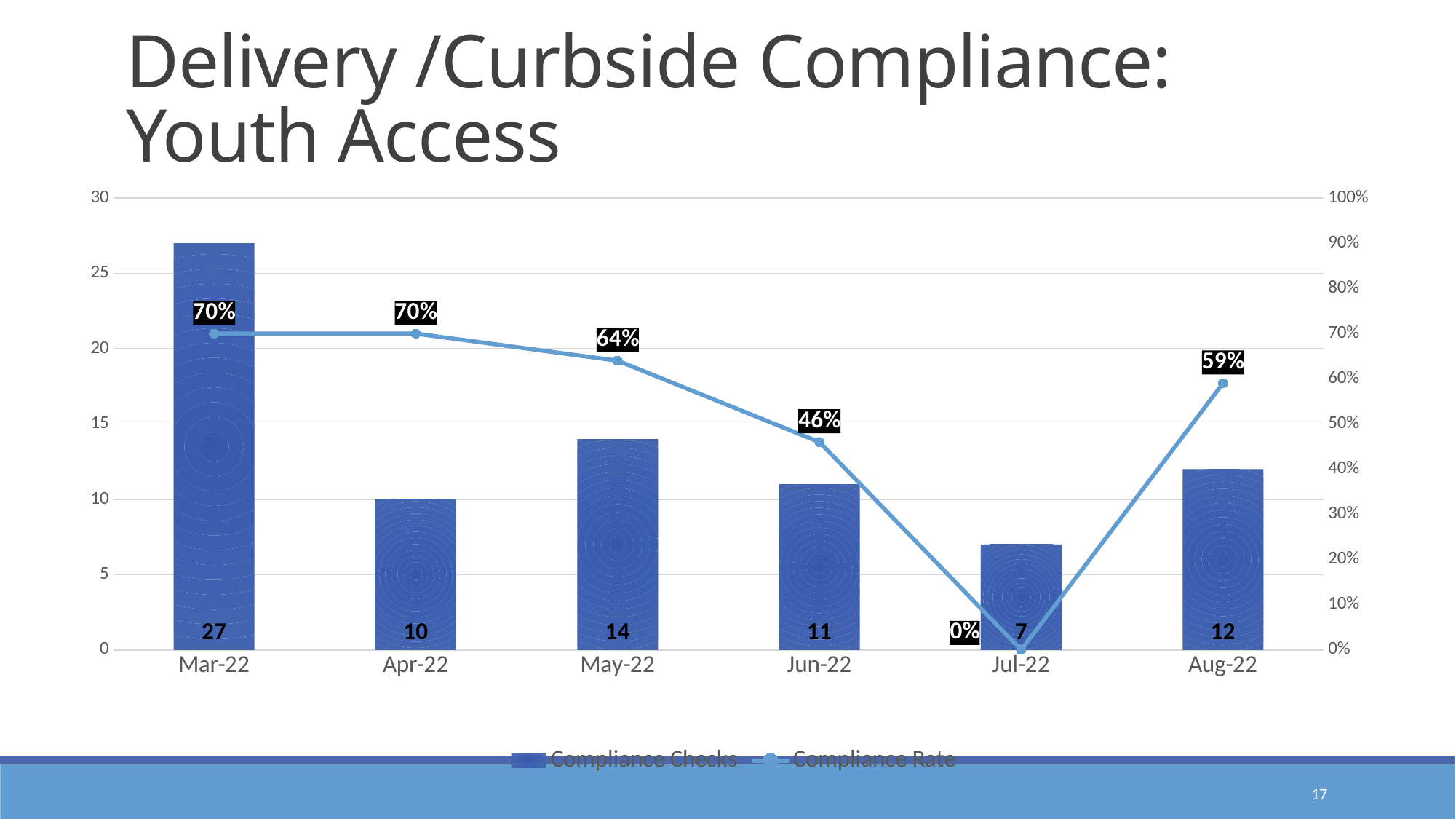
How many series does the legend list? 2 Which month had more compliance checks, May-22 or Jun-22? May-22 How many months are shown on the x axis? 6 What is the title of the slide containing the chart? Delivery /Curbside Compliance: Youth Access Does the compliance rate rise or fall from Apr-22 to Jul-22? Fall What was the compliance rate in Aug-22? 59% What is the difference in compliance checks between Mar-22 and Apr-22? 17 How many compliance checks were conducted in Mar-22? 27 Which month had the lowest compliance rate? Jul-22 What was the compliance rate in Jun-22? 46% Which month had the highest number of compliance checks? Mar-22 What kind of chart is shown on the slide? Combined bar and line chart